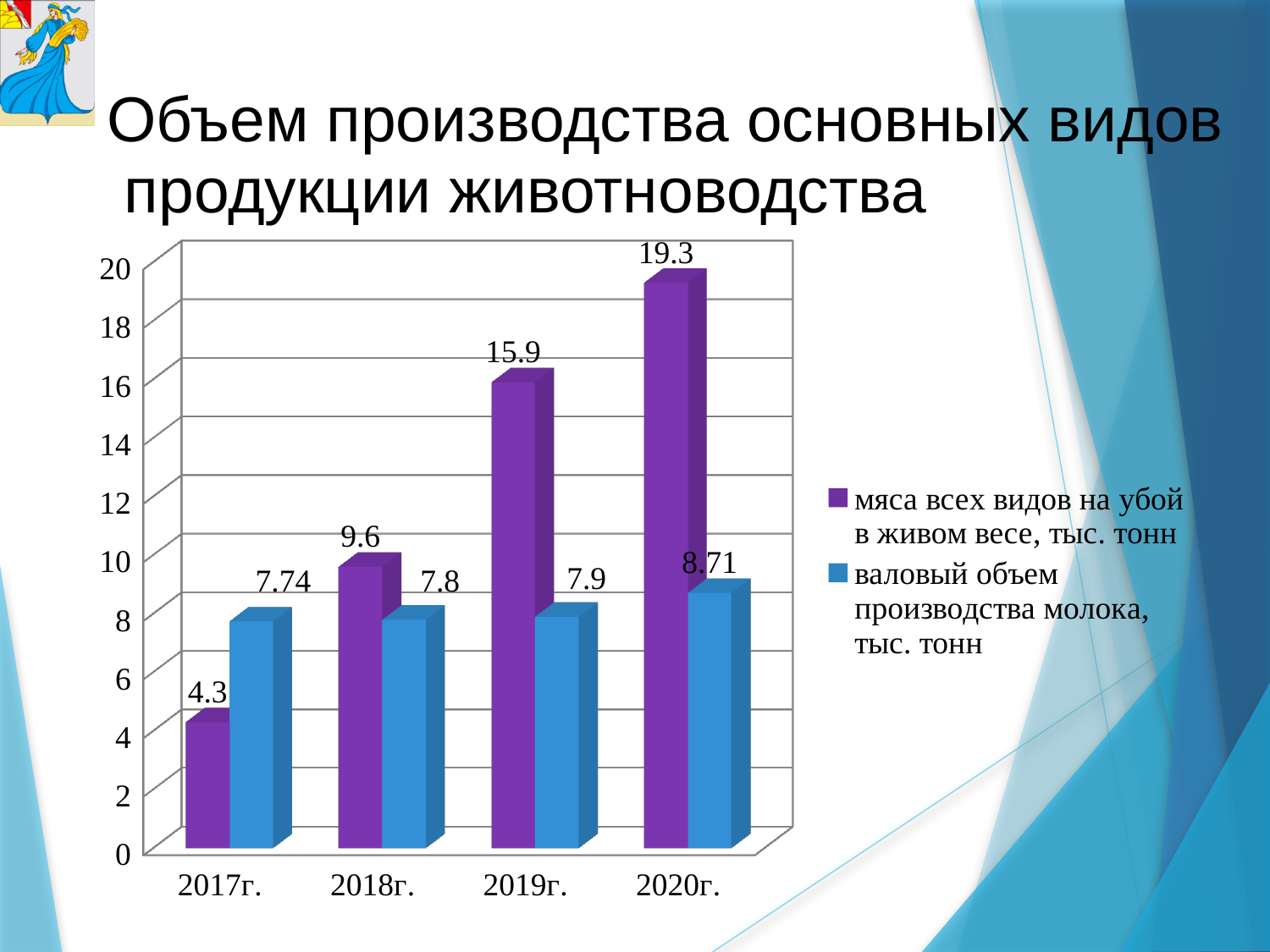
What is the value for meat production (мяса всех видов на убой в живом весе) in 2019г.? 15.9 What is the value for milk production (валовый объем производства молока) in 2020г.? 8.71 How many years are shown on the x axis? 4 How many series does the legend list? 2 Which is larger in 2018г.: meat production or milk production? meat production (9.6) Does meat production rise or fall from 2017г. to 2020г.? rise What kind of chart is shown on the slide? bar chart What is the difference between meat production in 2020г. and 2019г.? 3.4 In which year is meat production highest? 2020г. What is the value for meat production in 2017г.? 4.3 What is the difference between milk production in 2020г. and 2017г.? 0.97 In which year is meat production lowest? 2017г.